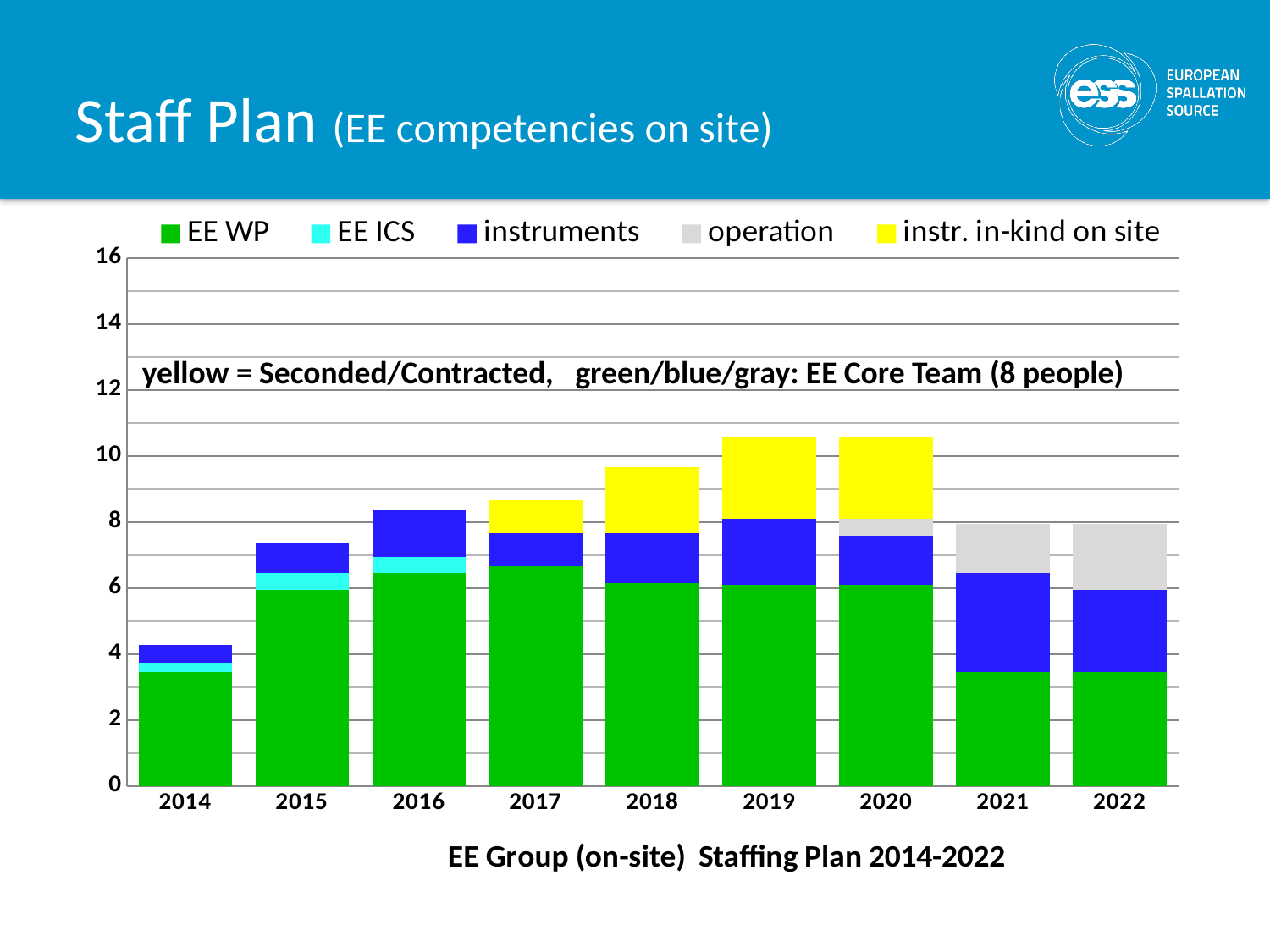
Is the total bar height for 2019 greater or less than 10? greater How many series does the chart legend list? 5 Which year has the lowest total bar height in the chart? 2014 Which year has a larger total bar, 2014 or 2015? 2015 What kind of chart is shown on the slide? Stacked bar chart Is the total bar height for 2018 greater or less than 8? greater Which year has a larger total bar, 2018 or 2022? 2018 Do the total bar heights rise or fall from 2014 to 2019? Rise How many years (categories) are shown on the x axis of the chart? 9 What is the caption printed below the chart? EE Group (on-site) Staffing Plan 2014-2022 Is the total bar height for 2021 greater or less than 10? less